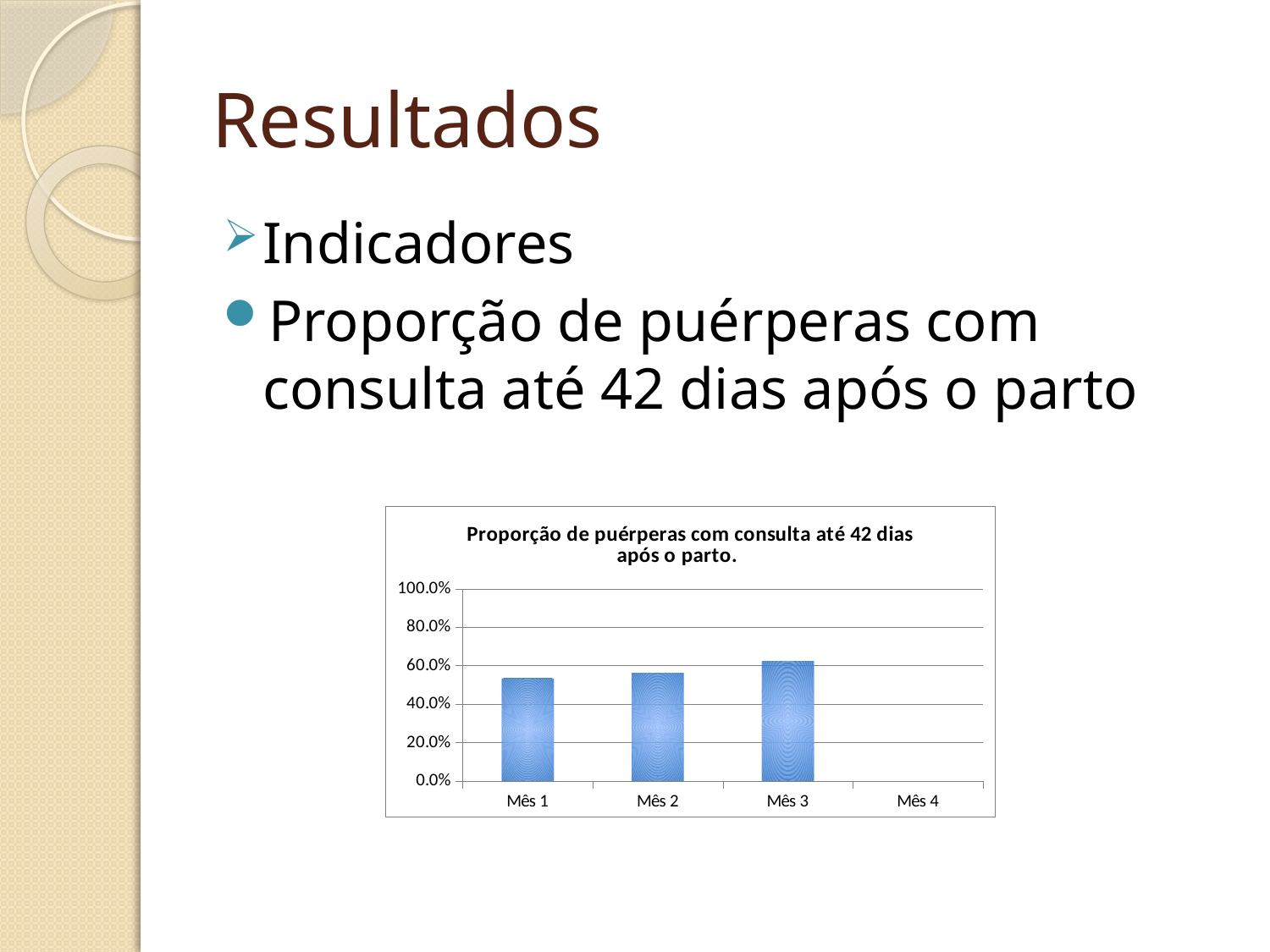
How many categories are shown on the x axis of the chart? 4 Is the value for Mês 1 greater or less than 60.0%? less Is the value for Mês 3 greater or less than 40.0%? greater Do the values rise or fall from Mês 1 to Mês 3? rise Which month has the highest bar in the chart? Mês 3 Is the value for Mês 2 greater or less than 60.0%? less Which is larger, the value for Mês 1 or the value for Mês 3? Mês 3 Which category on the x axis has no visible bar? Mês 4 What kind of chart is shown on the slide? bar chart What is the title of the chart? Proporção de puérperas com consulta até 42 dias após o parto.